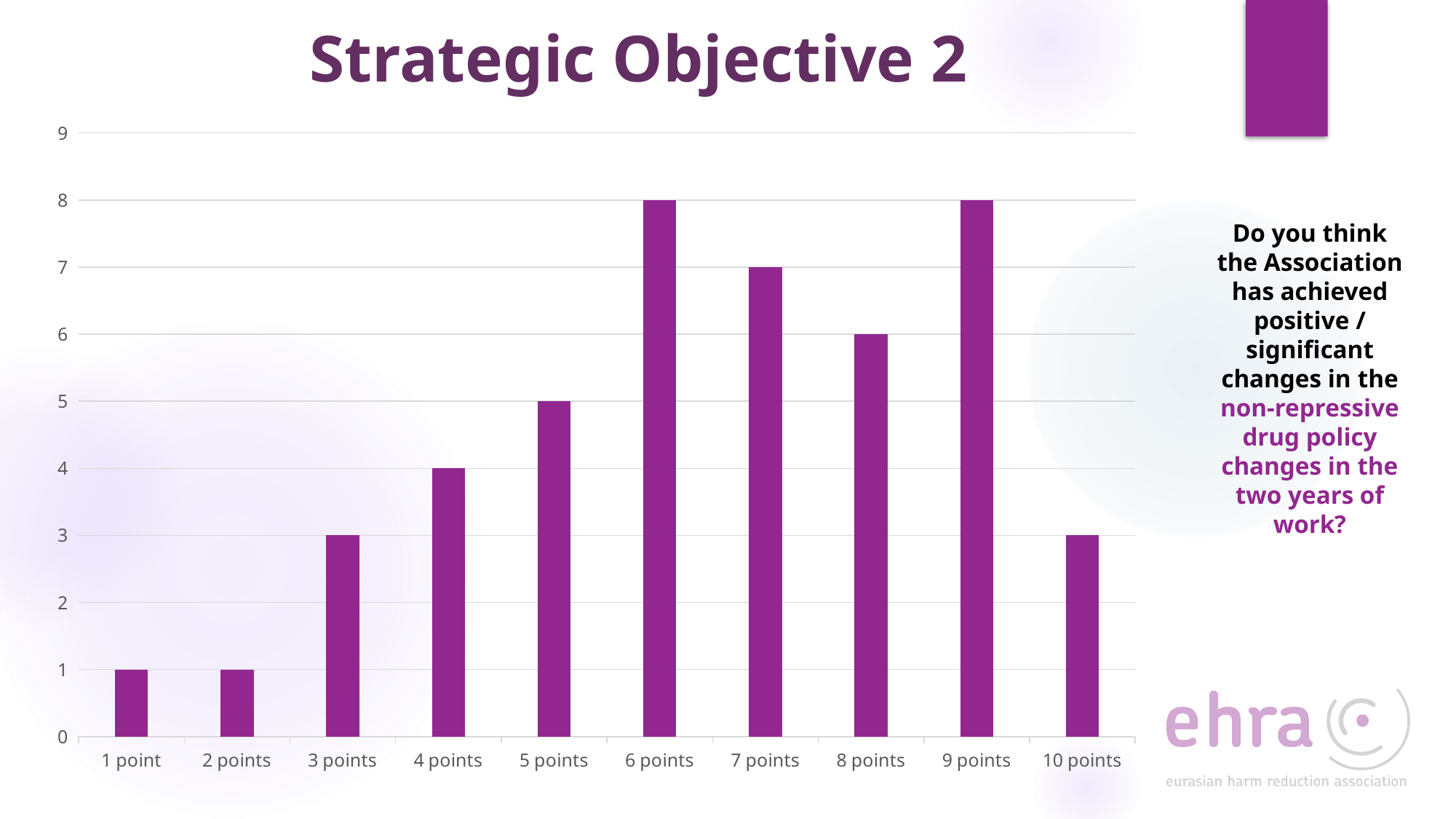
What is the value for 6 points? 8 What is the title of the slide? Strategic Objective 2 What is the value for 8 points? 6 What is the value for 10 points? 3 Which is larger, the value for 7 points or the value for 8 points? 7 points What is the value for 1 point? 1 What is the value for 4 points? 4 What kind of chart is shown on the slide? bar chart Is the value for 4 points greater or less than 5? less How many categories are shown on the x axis? 10 What is the difference between the values for 6 points and 5 points? 3 Do the values rise or fall from 1 point to 6 points? rise